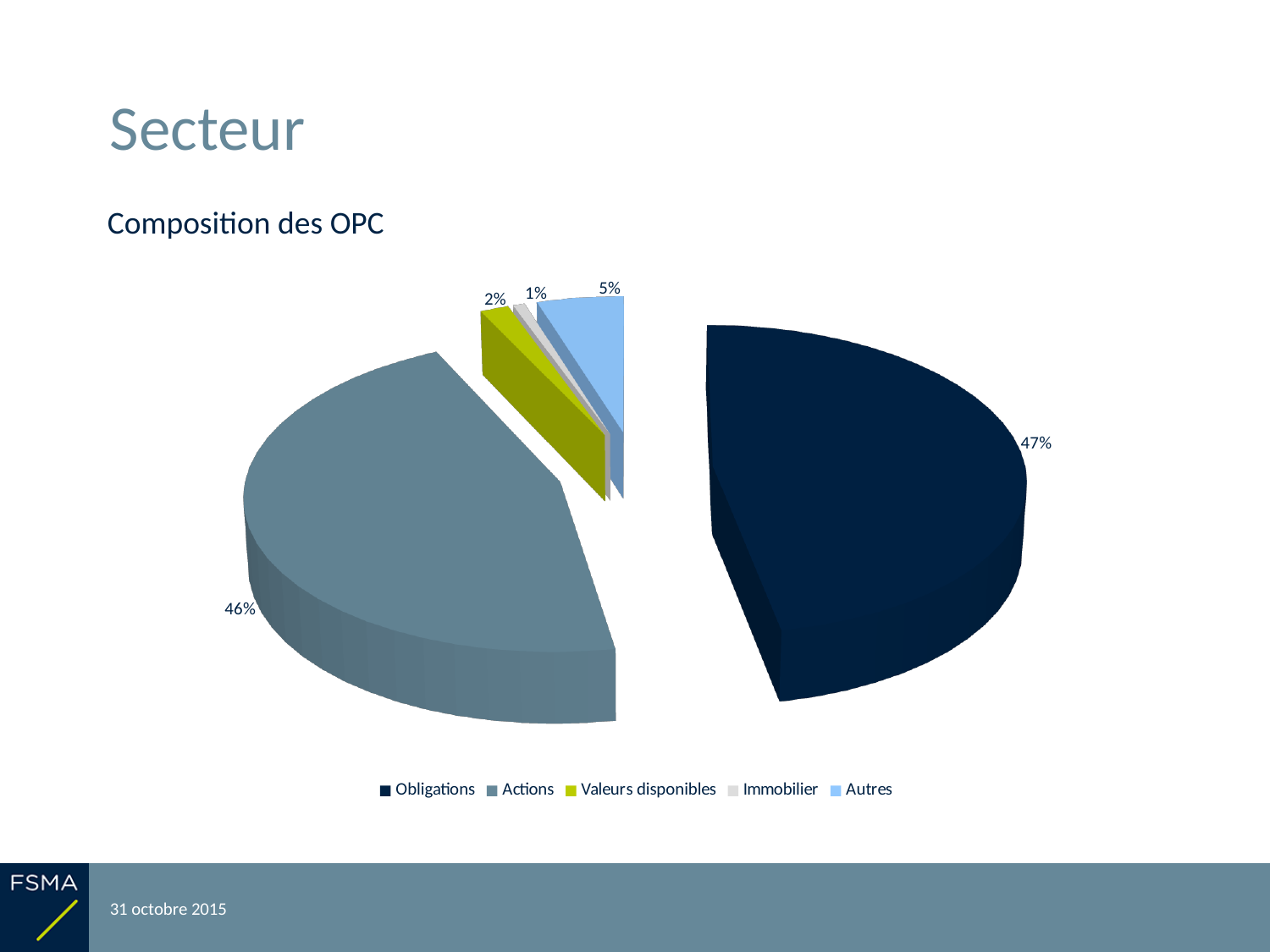
Which is larger, the share for Autres or the share for Valeurs disponibles? Autres What percentage is shown for Valeurs disponibles? 2% What kind of chart is shown on the slide? Pie chart What percentage is shown for Autres? 5% Which category has the largest slice of the pie? Obligations What is the difference in percentage points between Obligations and Actions? 1 percentage point What share of the pie does Actions represent? 46% What percentage is shown for Immobilier? 1% What is the title of the chart? Composition des OPC Which category has the smallest slice of the pie? Immobilier What share of the pie does Obligations represent? 47% How many categories does the legend list? 5